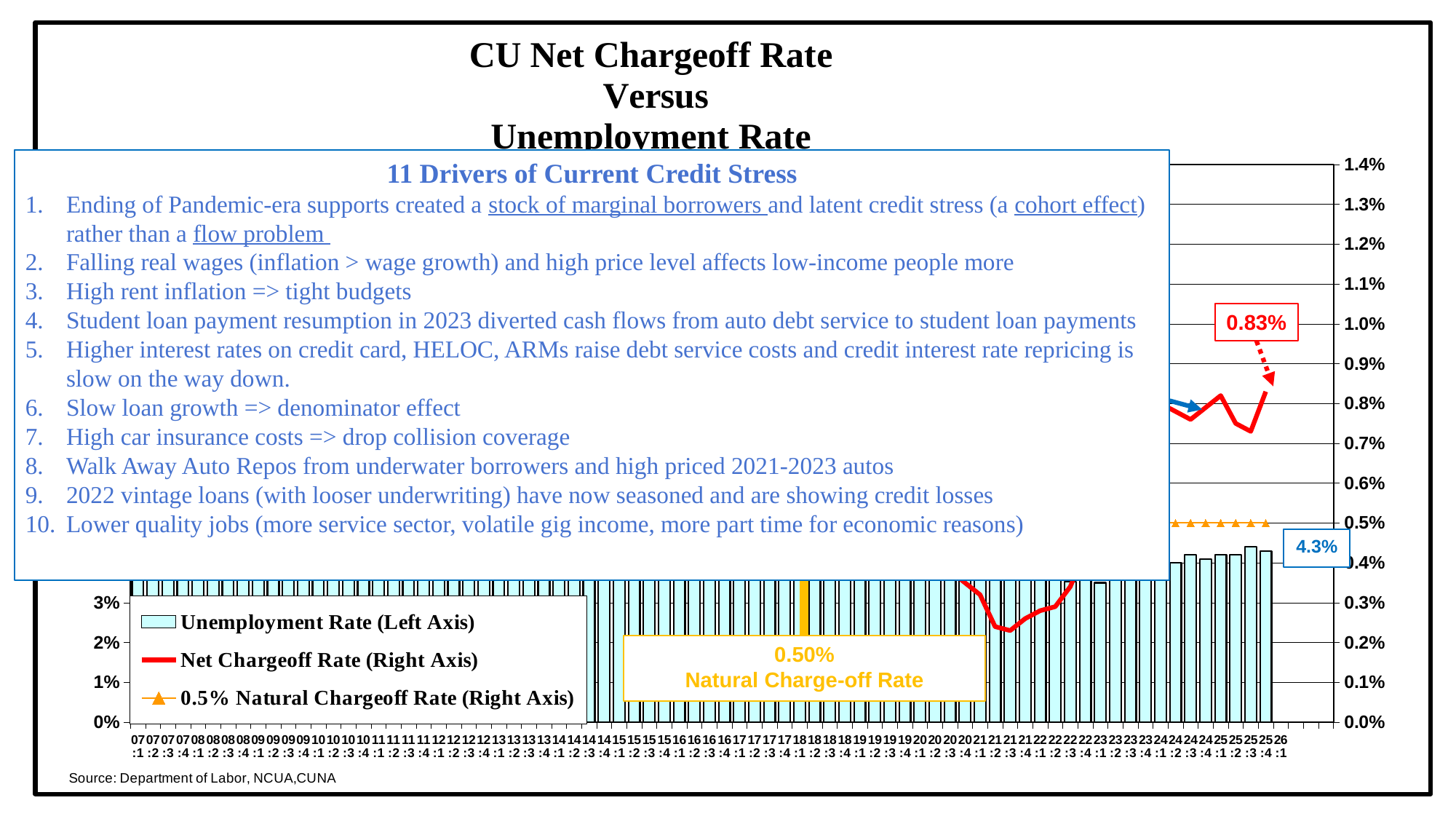
What is the Natural Charge-off Rate shown on the chart? 0.50% What is the title of the chart? CU Net Chargeoff Rate Versus Unemployment Rate Is the Unemployment Rate series plotted as bars or as a line? bars From its low point in 2021 through 2022, does the Net Chargeoff Rate line rise or fall? rise What value is labeled for the Unemployment Rate at the right end of the bars? 4.3% What value is labeled for the projected Net Chargeoff Rate at the right end of the red line? 0.83% What sources are cited for the chart? Department of Labor, NCUA, CUNA Which is larger, the labeled Net Chargeoff Rate of 0.83% or the Natural Charge-off Rate of 0.50%? Net Chargeoff Rate (0.83%) Is the lowest visible point of the Net Chargeoff Rate line, around 2021, greater or less than 0.3%? less What is the highest tick shown on the right-hand axis? 1.4% How many series does the chart legend list? 3 What is the difference between the labeled Net Chargeoff Rate (0.83%) and the Natural Charge-off Rate (0.50%)? 0.33%